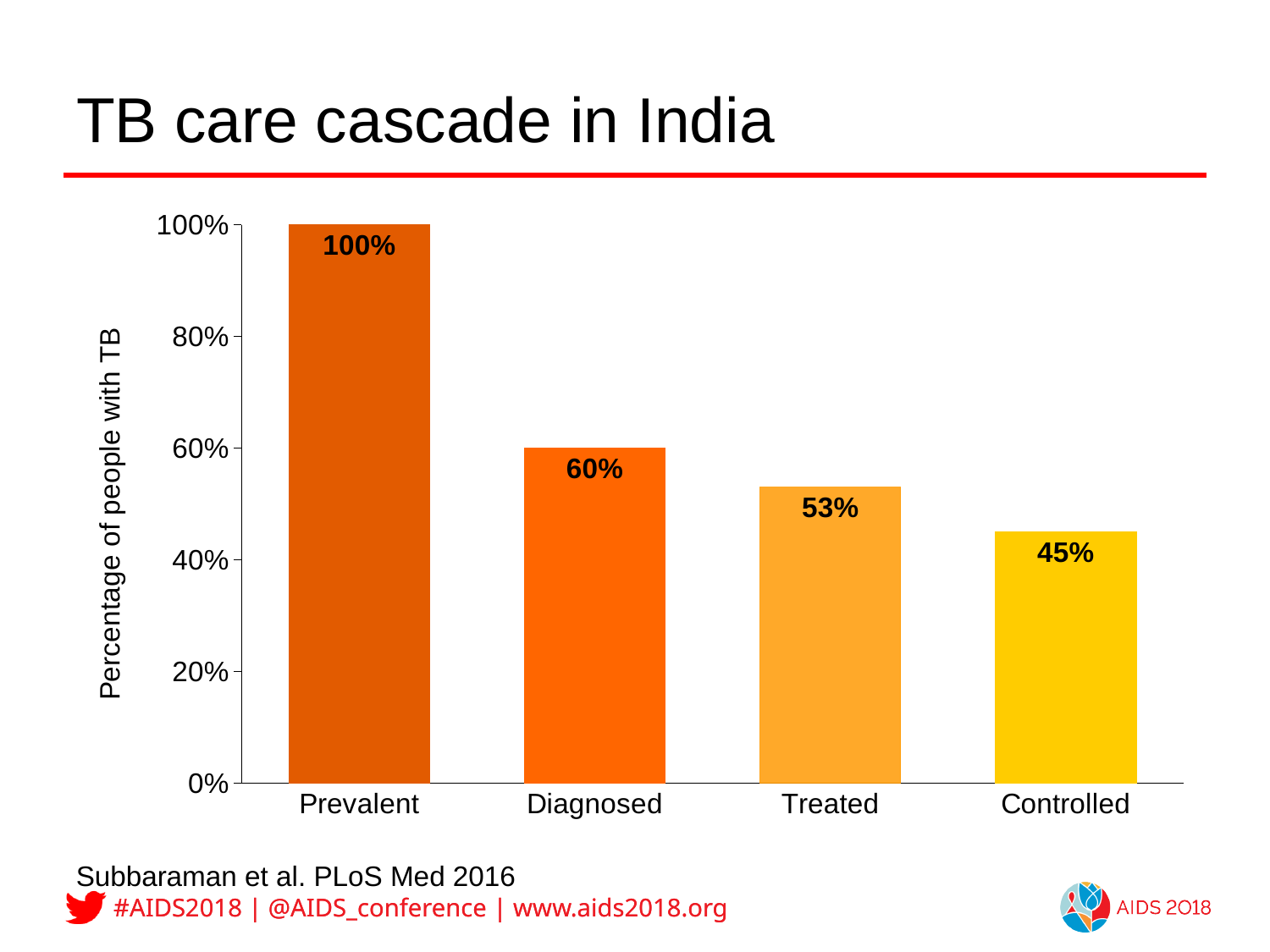
What kind of chart is shown on the slide? bar chart Do the values rise or fall from Prevalent to Controlled? fall What is the value for Controlled? 45% What is the difference between the values for Diagnosed and Treated? 7% Which category has the highest value? Prevalent What is the value for Diagnosed? 60% Which is larger, the value for Treated or the value for Controlled? Treated What is the value for Treated? 53% Is the value for Treated greater or less than 60%? less What is the difference between the values for Prevalent and Controlled? 55% How many categories are shown on the x axis? 4 Which category has the lowest value? Controlled